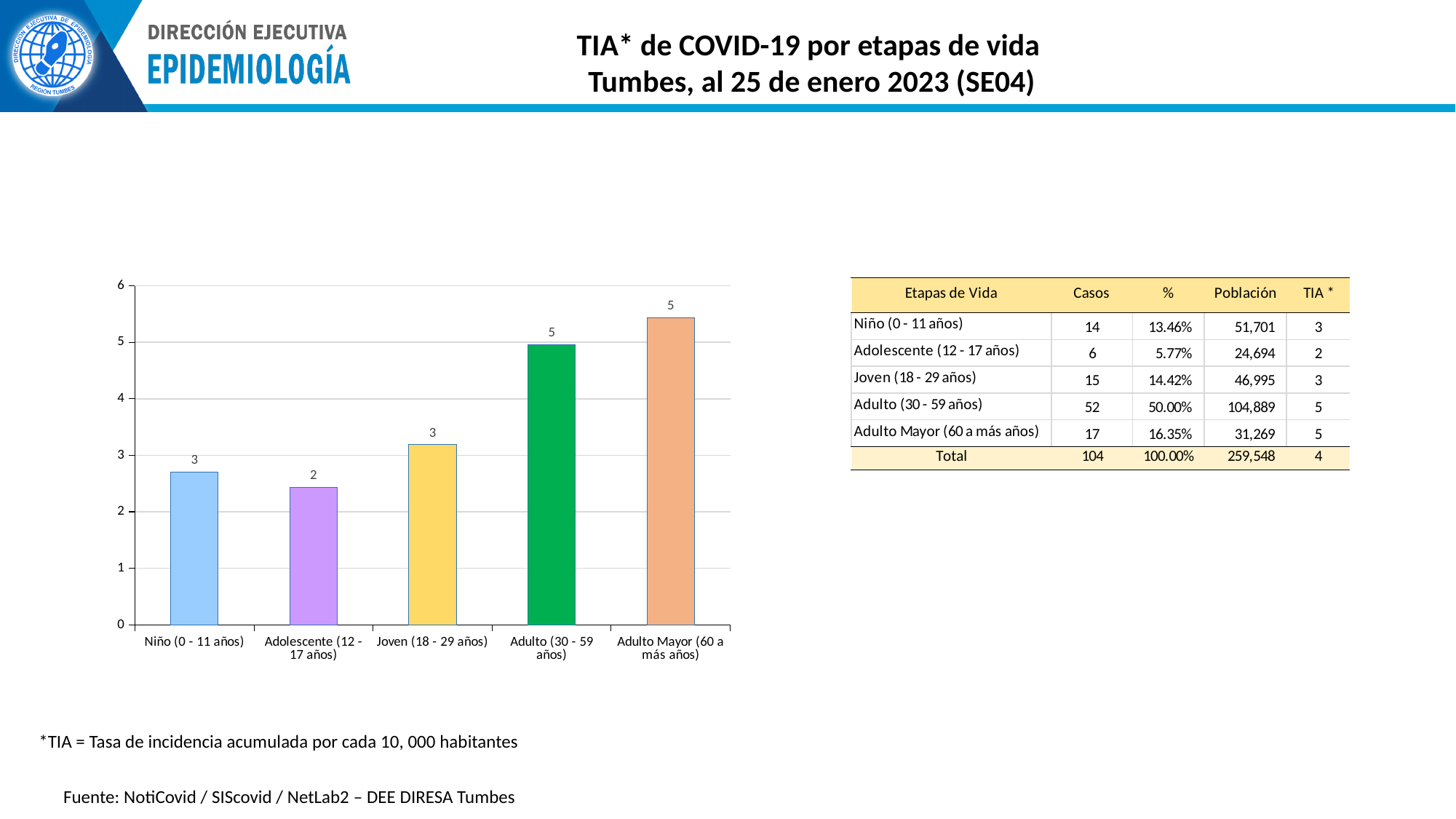
What is the TIA value shown for Adulto (30 - 59 años)? 5 How many life-stage categories are plotted in the chart? 5 Which is larger, the TIA for Adulto (30 - 59 años) or for Adolescente (12 - 17 años)? Adulto (30 - 59 años) What is the TIA value shown for Adolescente (12 - 17 años)? 2 Is the value for Adolescente (12 - 17 años) greater or less than 3? less From Adolescente (12 - 17 años) to Adulto Mayor (60 a más años), do the bar values rise or fall? Rise Is the value for Adulto (30 - 59 años) greater or less than 4? greater Which life stage has the lowest TIA in the chart? Adolescente (12 - 17 años) What is the TIA value shown for Joven (18 - 29 años)? 3 What kind of chart is shown on the slide? Bar chart What is the TIA value shown for Niño (0 - 11 años)? 3 What is the difference between the TIA labels for Adulto (30 - 59 años) and Adolescente (12 - 17 años)? 3